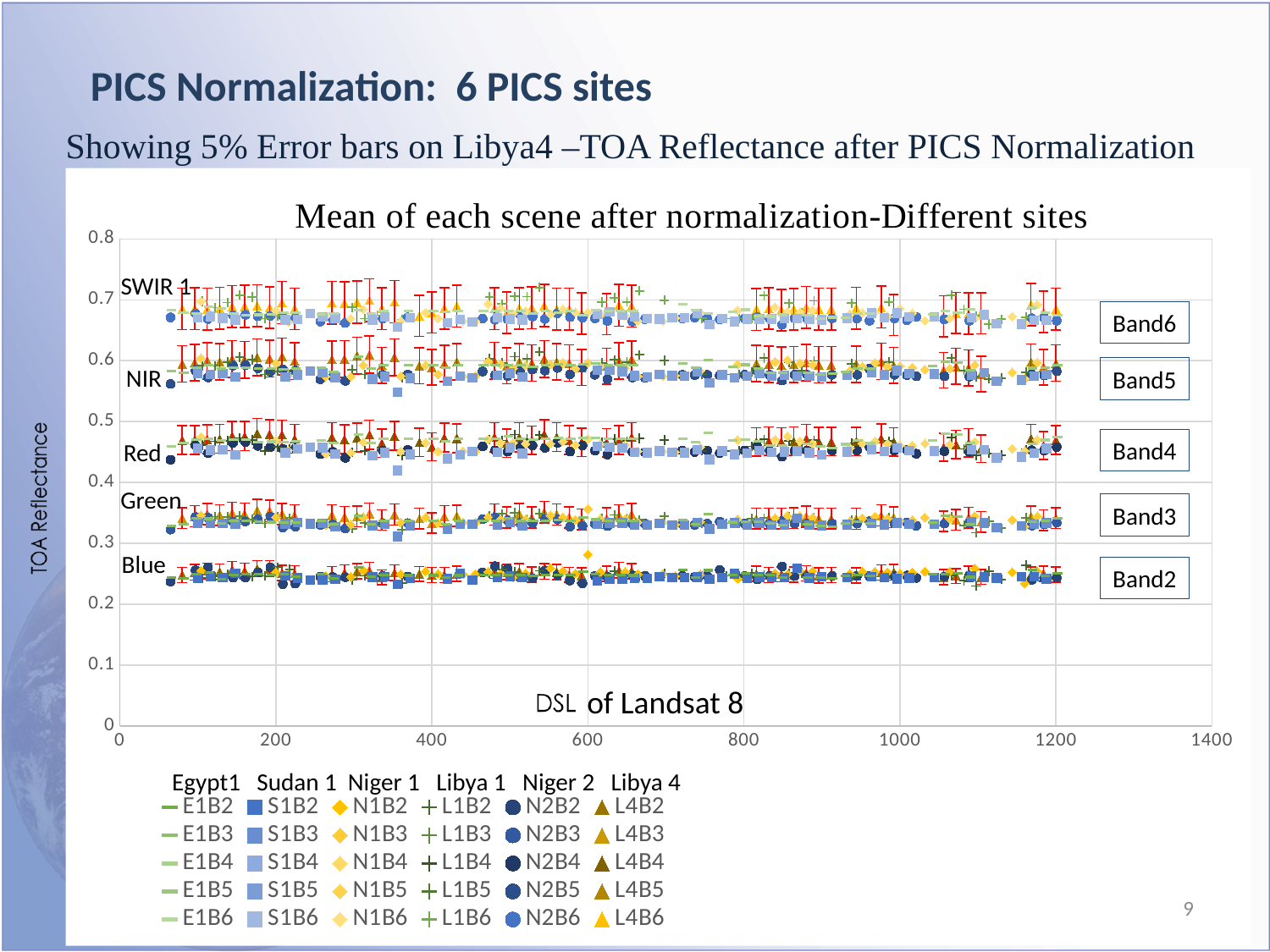
Which has higher TOA reflectance, the NIR band or the Green band? NIR Are the Red band (Band4) values greater or less than 0.5? less Are the Blue band (Band2) values greater or less than 0.3? less Which band has the highest TOA reflectance values in the chart? SWIR 1 (Band6) How many PICS sites are plotted in the chart? 6 Are the SWIR 1 (Band6) values greater or less than 0.6? greater Which band number label is shown next to the Red band in the chart? Band4 Do the reflectance values for each band rise, fall, or stay roughly flat as DSL increases along the x axis? stay roughly flat What kind of chart is shown on the slide? scatter chart What is the title of the chart? Mean of each scene after normalization-Different sites Which band has the lowest TOA reflectance values in the chart? Blue (Band2) How many series does the chart legend list? 30